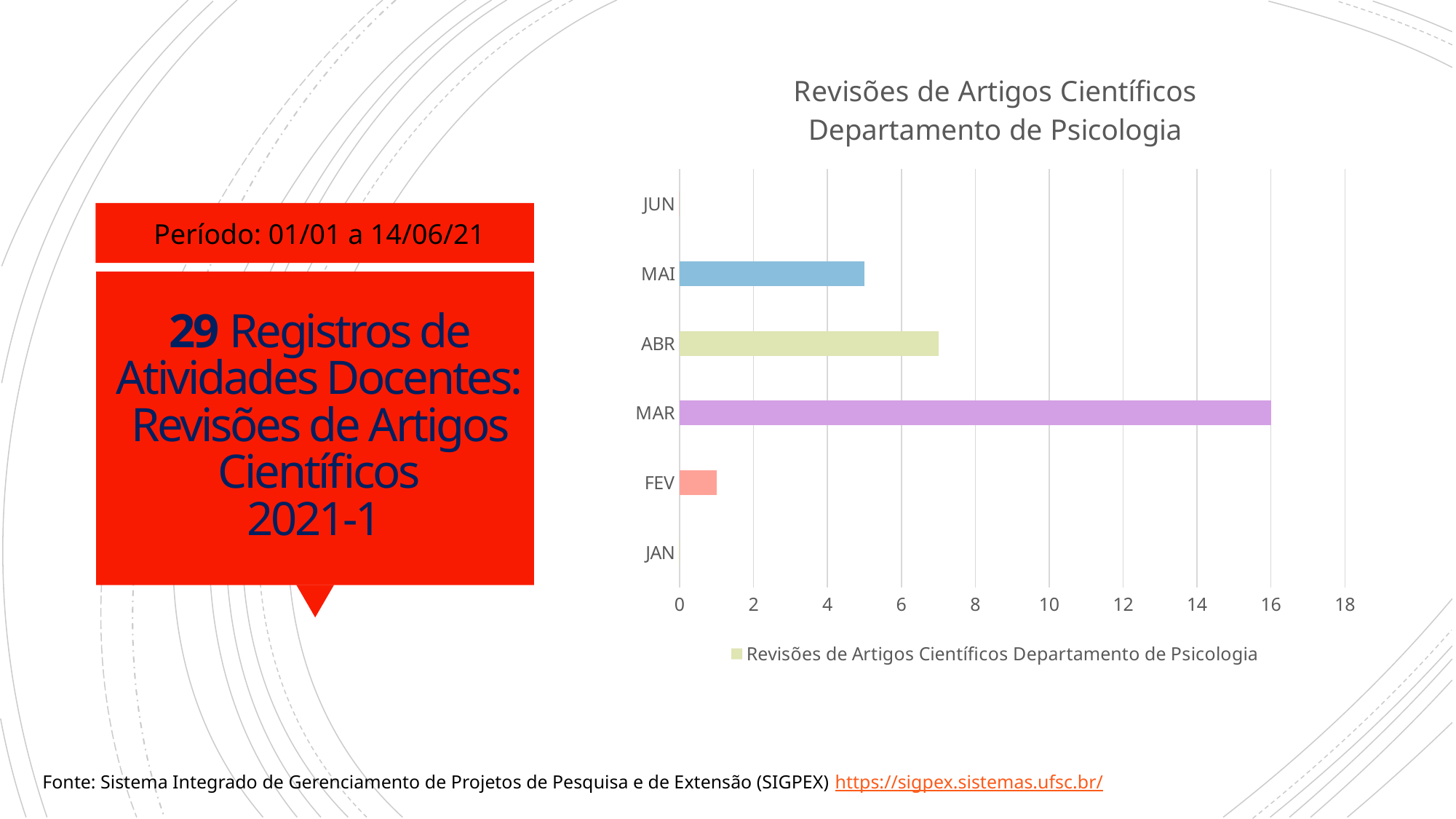
How many series does the chart legend list? 1 Which has a larger value, MAR or ABR? MAR What type of chart is shown on the slide? Bar chart Is the value for ABR greater or less than 6? greater Is the value for FEV greater or less than 2? less Is the value for MAI greater or less than 4? greater What is the value for MAR in the chart? 16 Which month has the highest value in the chart? MAR Among the months with a visible bar, which has the shortest bar? FEV What is the title of the chart? Revisões de Artigos Científicos Departamento de Psicologia Which has a larger value, ABR or MAI? ABR How many months are listed on the vertical axis of the chart? 6